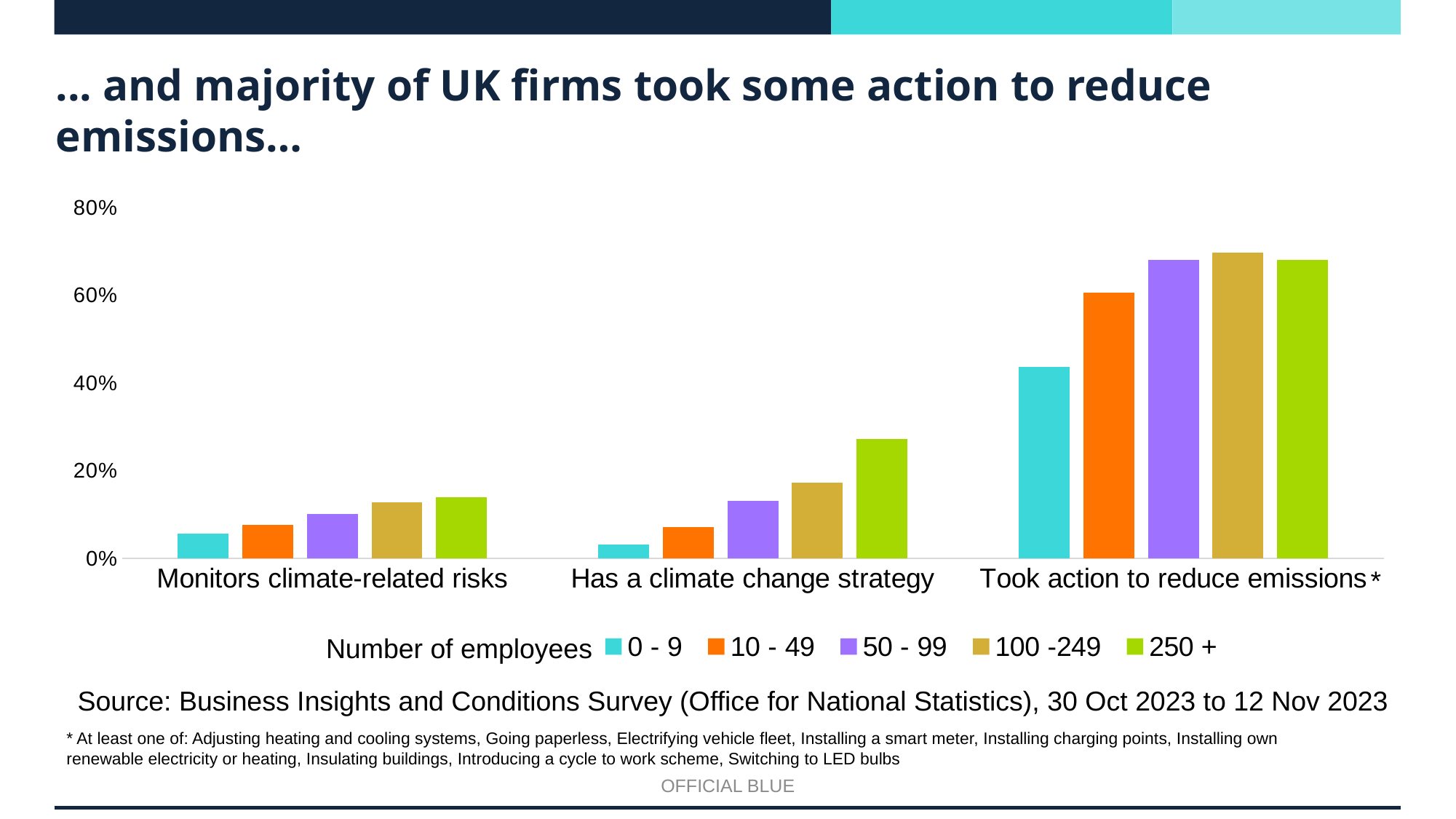
What kind of chart is shown on the slide? bar chart What is the title of the chart's legend? Number of employees Is the value for firms with 50 - 99 employees that took action to reduce emissions greater or less than 60%? greater How many categories are shown on the x axis of the chart? 3 Is the value for firms with 250 + employees that have a climate change strategy greater or less than 20%? greater Within the 'Has a climate change strategy' category, which employee size band has the highest value? 250 + For firms with 250 + employees, which is larger: the value for 'Monitors climate-related risks' or for 'Has a climate change strategy'? Has a climate change strategy Is the value for firms with 100 -249 employees that monitor climate-related risks greater or less than 20%? less Within the 'Took action to reduce emissions' category, which employee size band has the lowest value? 0 - 9 Within the 'Has a climate change strategy' category, do the values rise or fall as the number of employees increases? rise How many series does the chart's legend list? 5